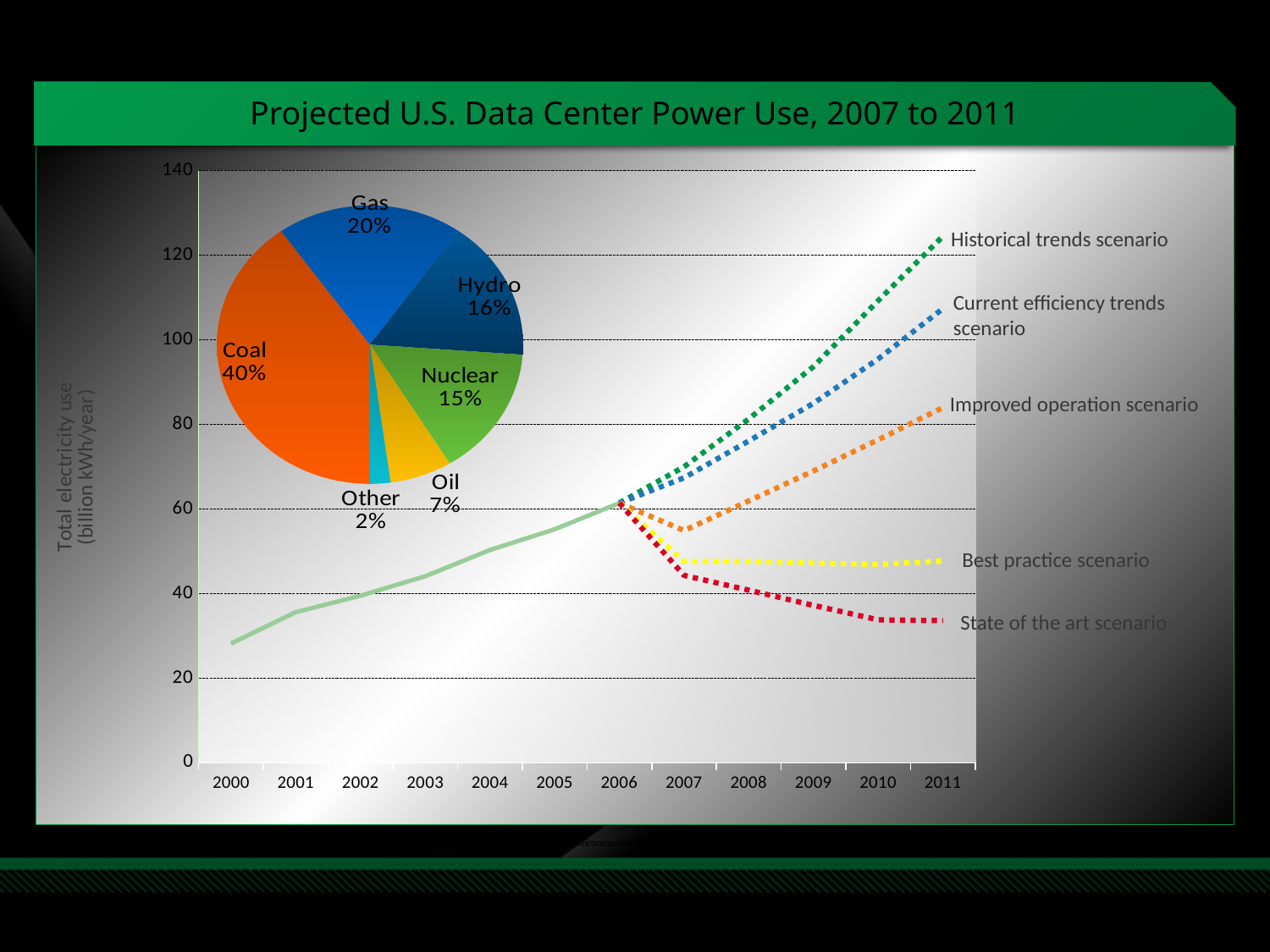
In the line chart titled 'Projected U.S. Data Center Power Use, 2007 to 2011', is the 2011 value for the Best practice scenario greater or less than 60? less In the line chart titled 'Projected U.S. Data Center Power Use, 2007 to 2011', is the 2011 value for the State of the art scenario greater or less than 40? less In the line chart titled 'Projected U.S. Data Center Power Use, 2007 to 2011', does the Historical trends scenario rise or fall from 2007 to 2011? rise In the line chart titled 'Projected U.S. Data Center Power Use, 2007 to 2011', how many scenarios are labelled for the projection period? 5 In the pie chart, which is larger, Oil or Hydro? Hydro In the pie chart, which category has the smallest share? Other In the pie chart, what share does Coal have? 40% In the pie chart, which category has the largest share? Coal In the line chart titled 'Projected U.S. Data Center Power Use, 2007 to 2011', is the 2011 value for the Current efficiency trends scenario greater or less than 100? greater In the pie chart, what share does Hydro have? 16% How many slices does the pie chart have? 6 In the pie chart, what is the difference between the Gas share and the Nuclear share? 5%